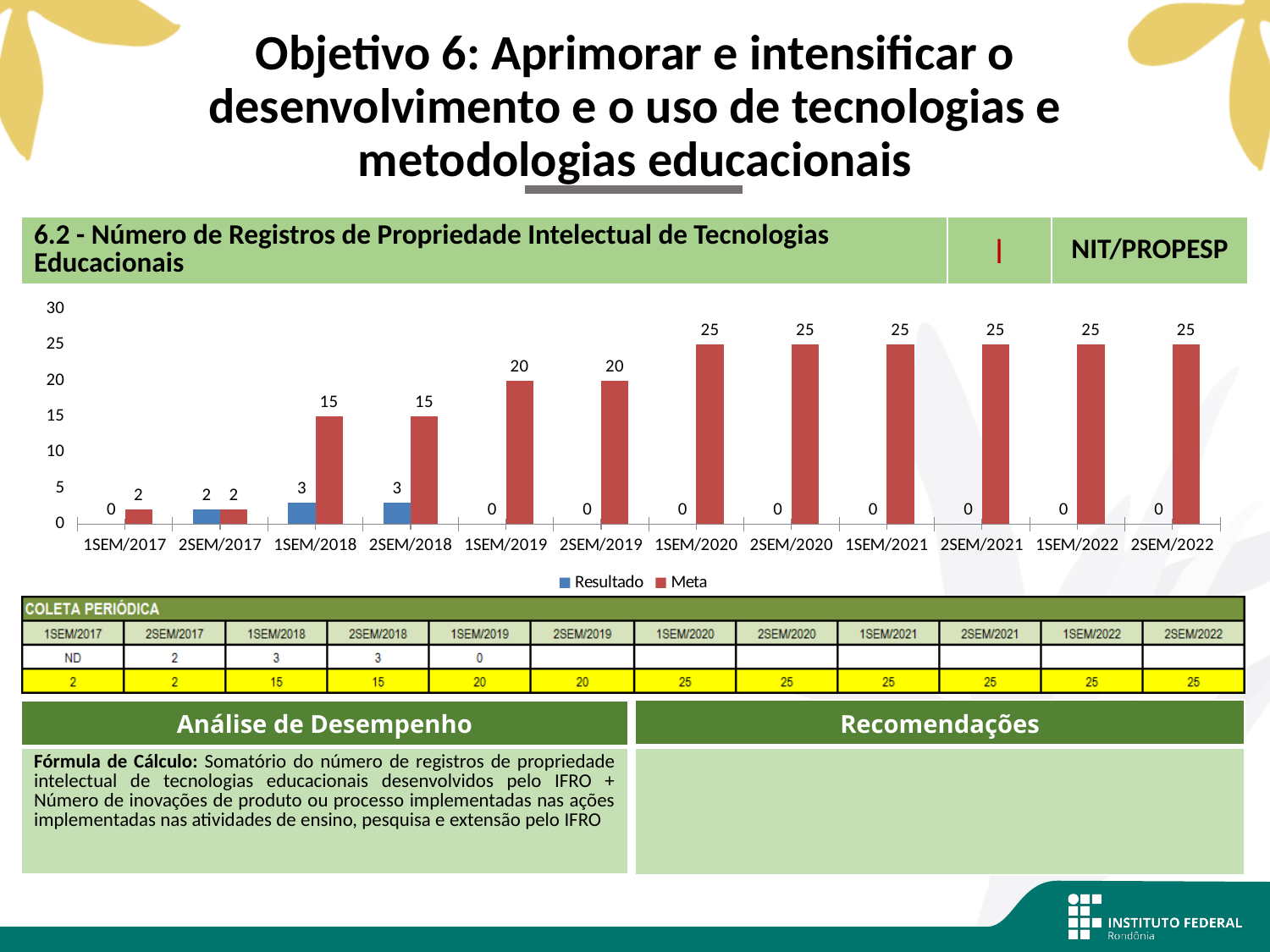
How many series does the chart legend list? 2 Which series is shown in red in the chart? Meta Does the Meta series rise or fall from 1SEM/2017 to 1SEM/2020? Rise What is the Resultado value for 2SEM/2018? 3 What is the Meta value for 2SEM/2019? 20 How many periods are shown on the x axis of the chart? 12 What is the difference between the Meta and the Resultado for 1SEM/2018? 12 Which period has the lowest Meta value? 1SEM/2017 and 2SEM/2017 What kind of chart is shown on the slide? Bar chart What is the Resultado value for 2SEM/2017? 2 What is the Meta value for 1SEM/2018? 15 Which is larger for 2SEM/2018, the Resultado or the Meta? Meta